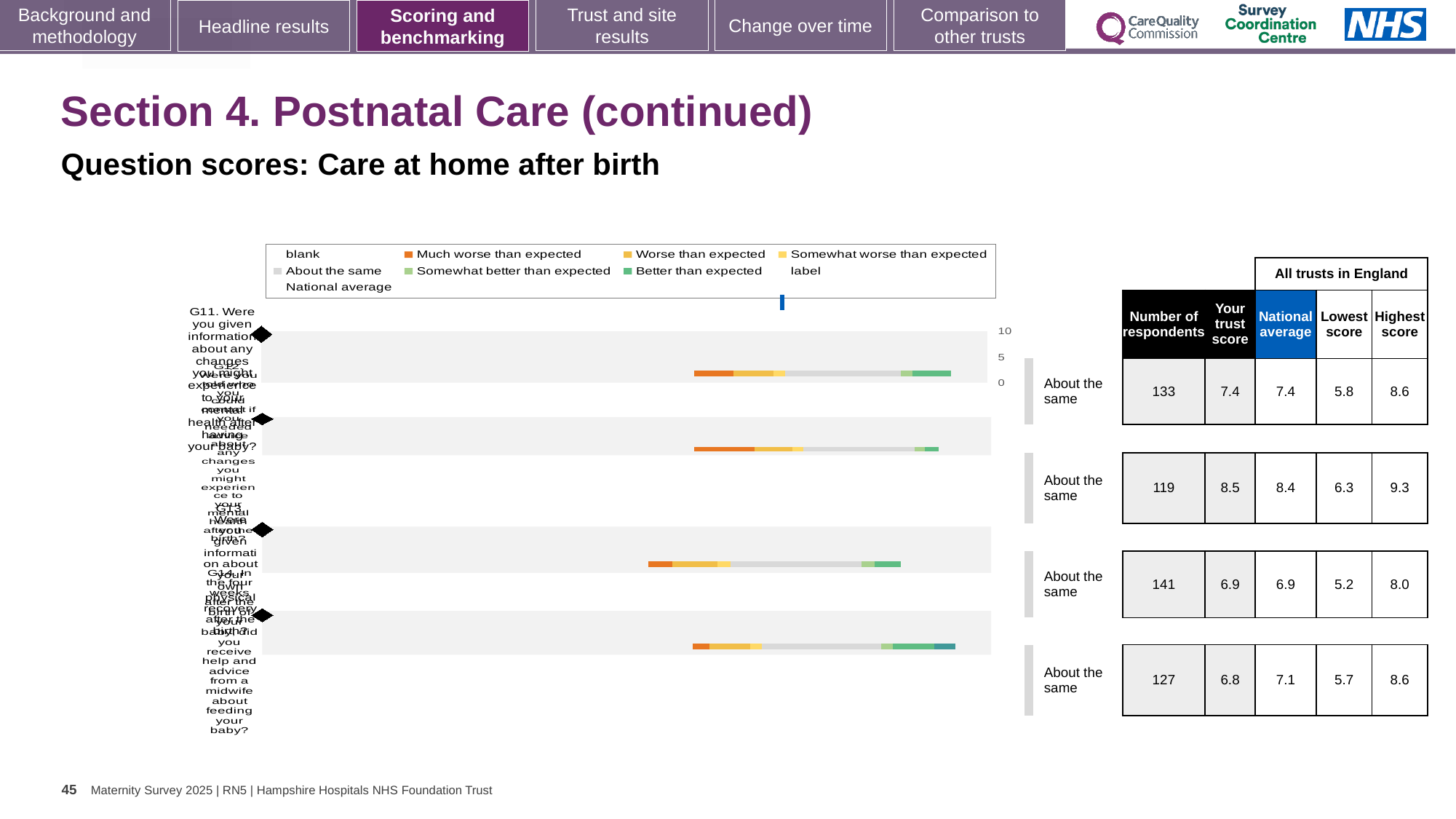
What is the difference between the highest score and the lowest score for the second question row? 3.0 What kind of chart is shown on the slide? bar chart In the chart legend, what colour is used for 'Better than expected'? green Which question row has the lowest 'Lowest score' value? the third row (5.2) What benchmark category is shown for all four question rows? About the same What is the number of respondents for the first (top) question row in the table? 133 For the fourth (bottom) question row, which is larger: the trust score or the national average? national average What is the 'Your trust score' value for the second question row? 8.5 How many question rows (bars) are plotted in the chart? 4 What is the national average for the fourth (bottom) question row? 7.1 In the chart legend, what colour is used for 'Much worse than expected'? orange Which question row has the highest number of respondents? the third row (141)